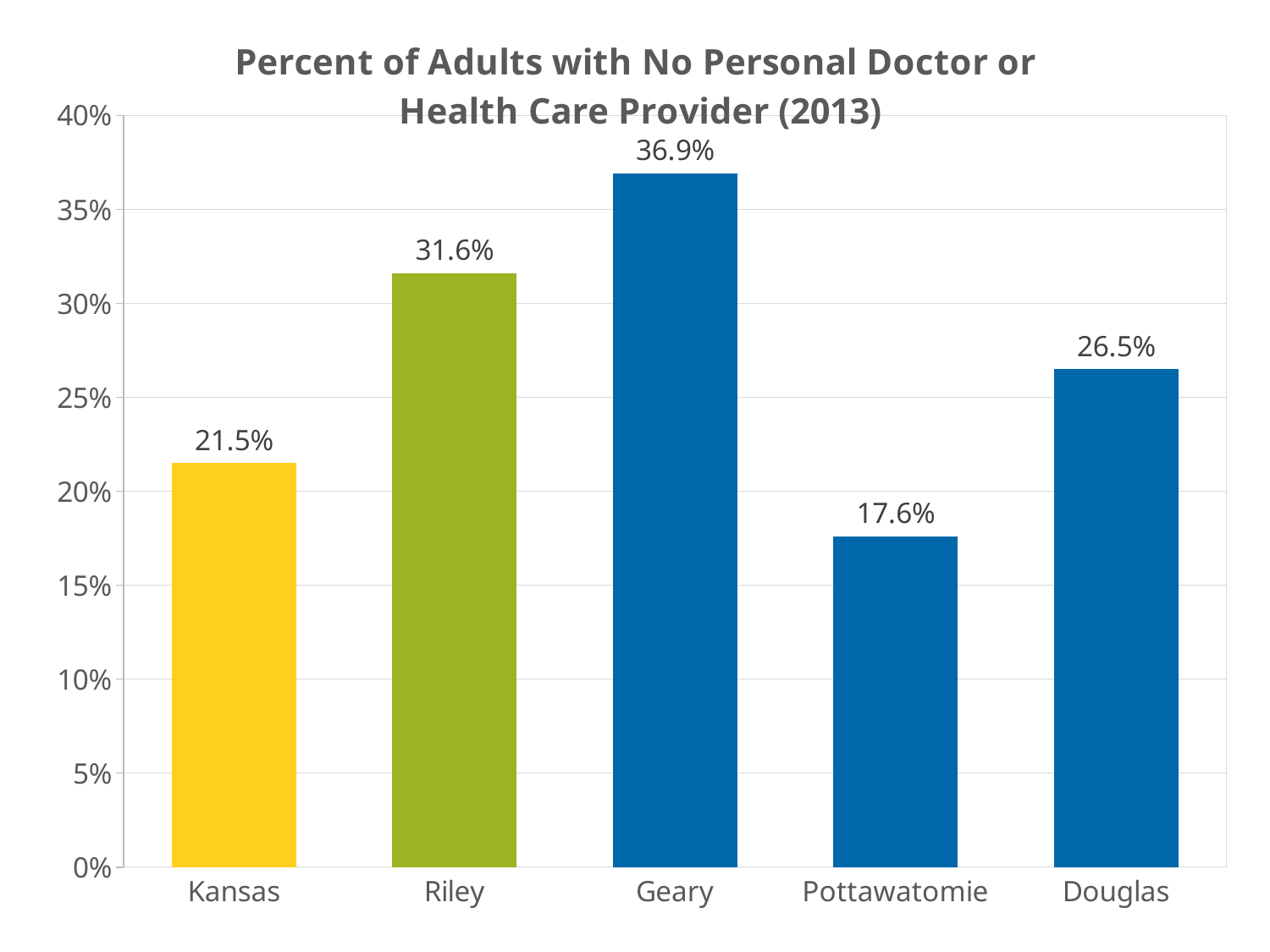
What is the difference between the values for Douglas and Kansas? 5.0% Which category has the highest value? Geary What is the value for Pottawatomie? 17.6% What is the title of the chart? Percent of Adults with No Personal Doctor or Health Care Provider (2013) What is the difference between the values for Geary and Riley? 5.3% How many categories are shown on the x axis? 5 What kind of chart is this? bar chart What is the value for Kansas? 21.5% Which is larger, the value for Douglas or the value for Kansas? Douglas Is the value for Geary greater or less than 35%? greater Which category has the lowest value? Pottawatomie What is the value for Riley? 31.6%